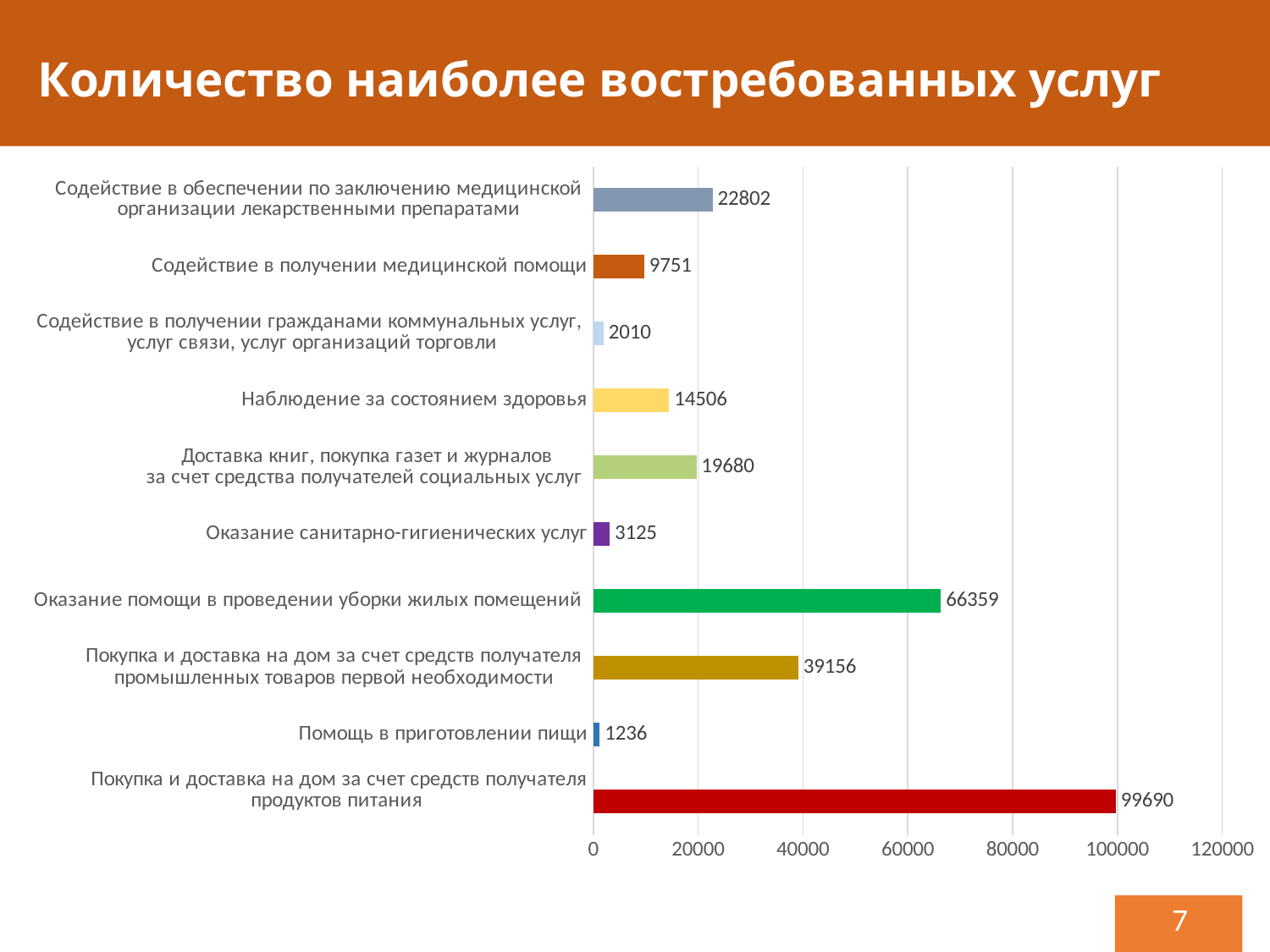
Which is larger: the value for «Содействие в получении медицинской помощи» or for «Наблюдение за состоянием здоровья»? Наблюдение за состоянием здоровья Is the value for «Покупка и доставка на дом за счет средств получателя промышленных товаров первой необходимости» greater or less than 40000? less What is the value for «Наблюдение за состоянием здоровья»? 14506 What is the title of the slide? Количество наиболее востребованных услуг What is the difference between the values for «Покупка и доставка на дом за счет средств получателя продуктов питания» and «Оказание помощи в проведении уборки жилых помещений»? 33331 Which category has the lowest value? Помощь в приготовлении пищи What is the value for «Помощь в приготовлении пищи»? 1236 How many categories are shown in the chart? 10 What kind of chart is shown on the slide? bar chart What is the value for «Оказание санитарно-гигиенических услуг»? 3125 Which category has the highest value? Покупка и доставка на дом за счет средств получателя продуктов питания What is the value for «Оказание помощи в проведении уборки жилых помещений»? 66359